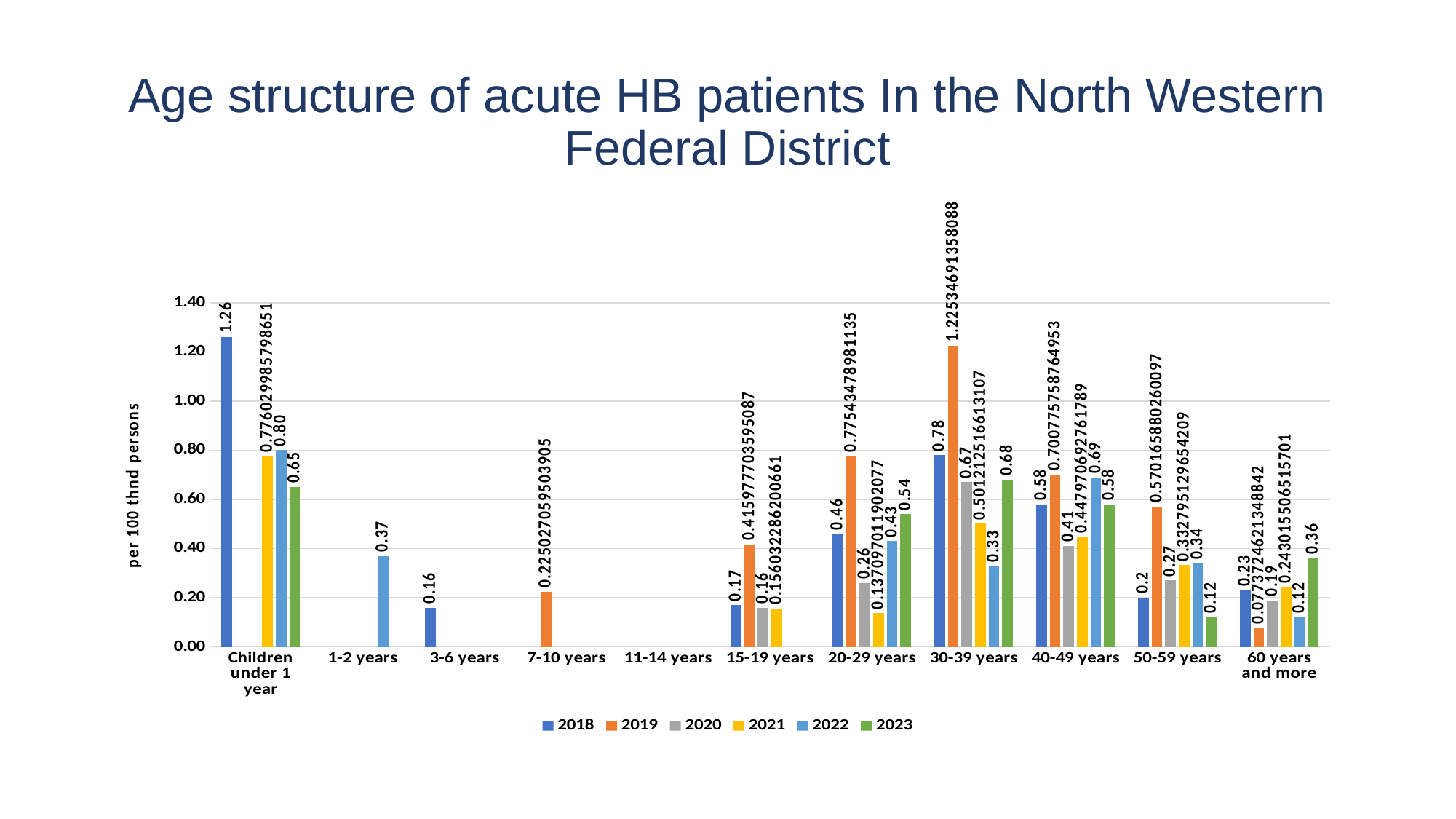
Which age category has the highest 2019 value? 30-39 years How many series does the legend list? 6 What kind of chart is shown on the slide? Bar chart What is the value for 2020 in the 50-59 years category? 0.27 What is the value for 2022 in the 1-2 years category? 0.37 What is the value for 2018 in the Children under 1 year category? 1.26 Is the 2019 value for 20-29 years greater or less than 0.60? greater Which age category has the lowest 2023 value? 50-59 years What is the value for 2023 in the 30-39 years category? 0.68 What is the difference between the 2018 values for 30-39 years and 20-29 years? 0.32 Which is larger, the 2022 value for 40-49 years or the 2022 value for 30-39 years? 40-49 years How many age categories are shown on the x axis? 11